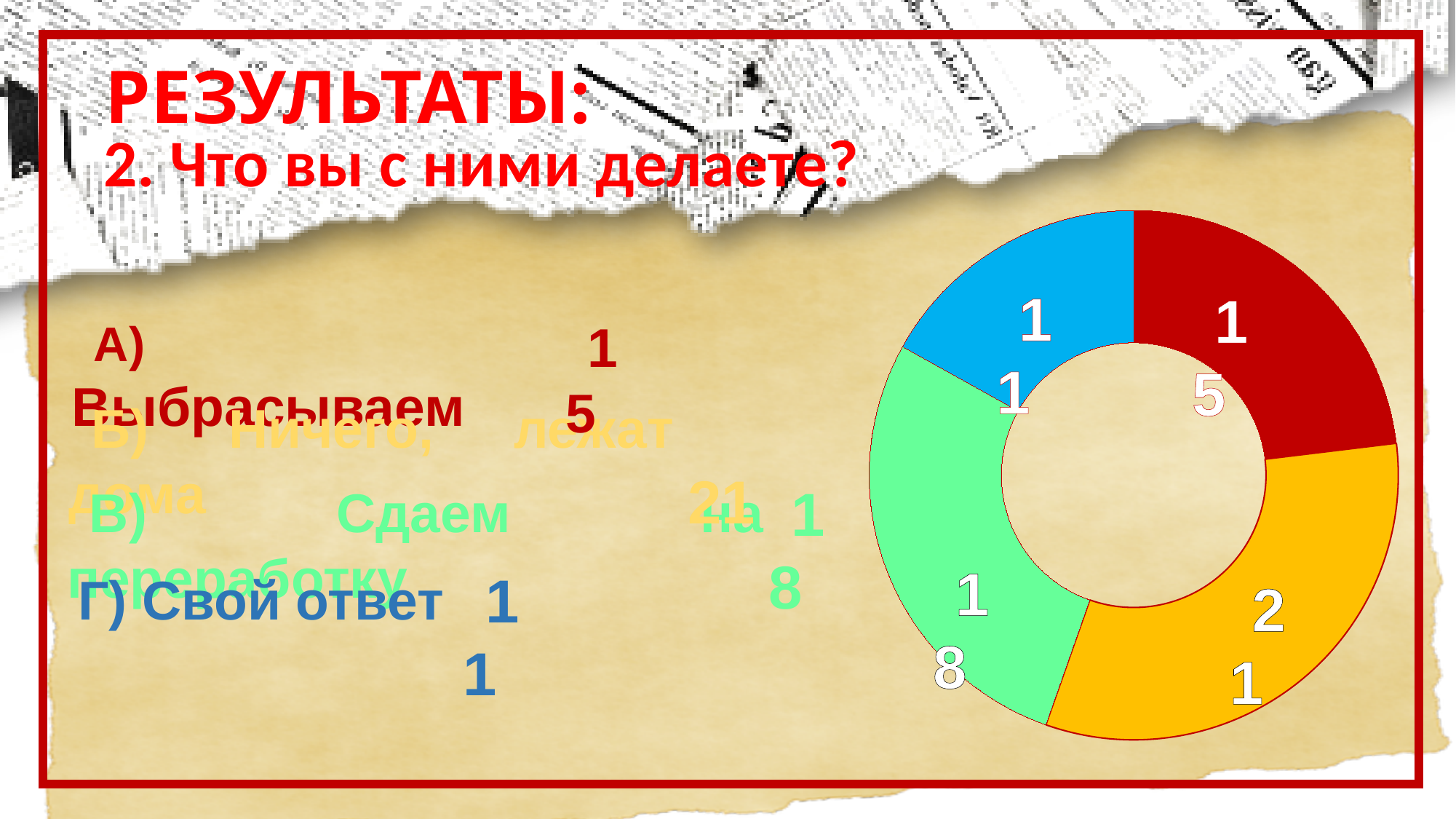
Which answer option has the smallest value in the chart? Г) Свой ответ How many slices does the doughnut chart have? 4 What colour is the slice for Сдаем на переработку? green What kind of chart is shown on the slide? doughnut chart Which answer option has the largest value in the chart? Б) Ничего, лежат дома What value is shown for the red slice (А) Выбрасываем)? 15 What value is shown for the green slice (В) Сдаем на переработку)? 18 What value is shown for the yellow slice (Б) Ничего, лежат дома)? 21 What is the difference between the values for Ничего, лежат дома and Выбрасываем? 6 Which is larger: the value for Сдаем на переработку or the value for Свой ответ? Сдаем на переработку What value is shown for the blue slice (Г) Свой ответ)? 11 What is the total of all four values in the chart? 65